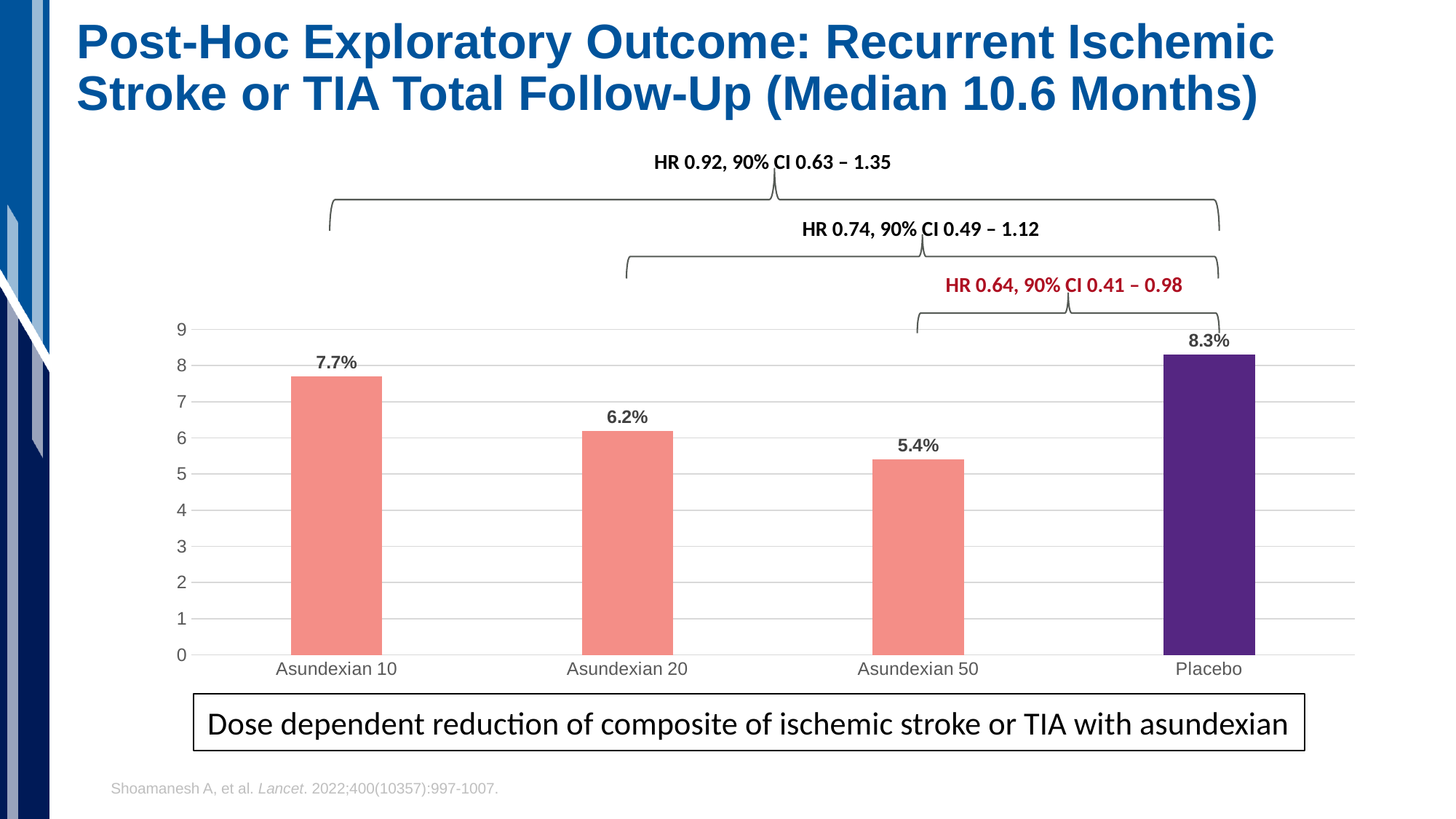
What is the value for Asundexian 50? 5.4% What is the value for Placebo? 8.3% Is the value for Asundexian 20 greater or less than 7? less How many categories are shown on the x axis? 4 What is the difference between the Asundexian 10 value and the Asundexian 20 value? 1.5% What hazard ratio is shown for the comparison of Asundexian 50 versus Placebo? HR 0.64, 90% CI 0.41 – 0.98 Which is larger, the value for Asundexian 20 or the value for Asundexian 10? Asundexian 10 What is the value for Asundexian 10? 7.7% What is the difference between the Placebo value and the Asundexian 50 value? 2.9% Which category has the highest value? Placebo Which category has the lowest value? Asundexian 50 What kind of chart is shown on the slide? bar chart